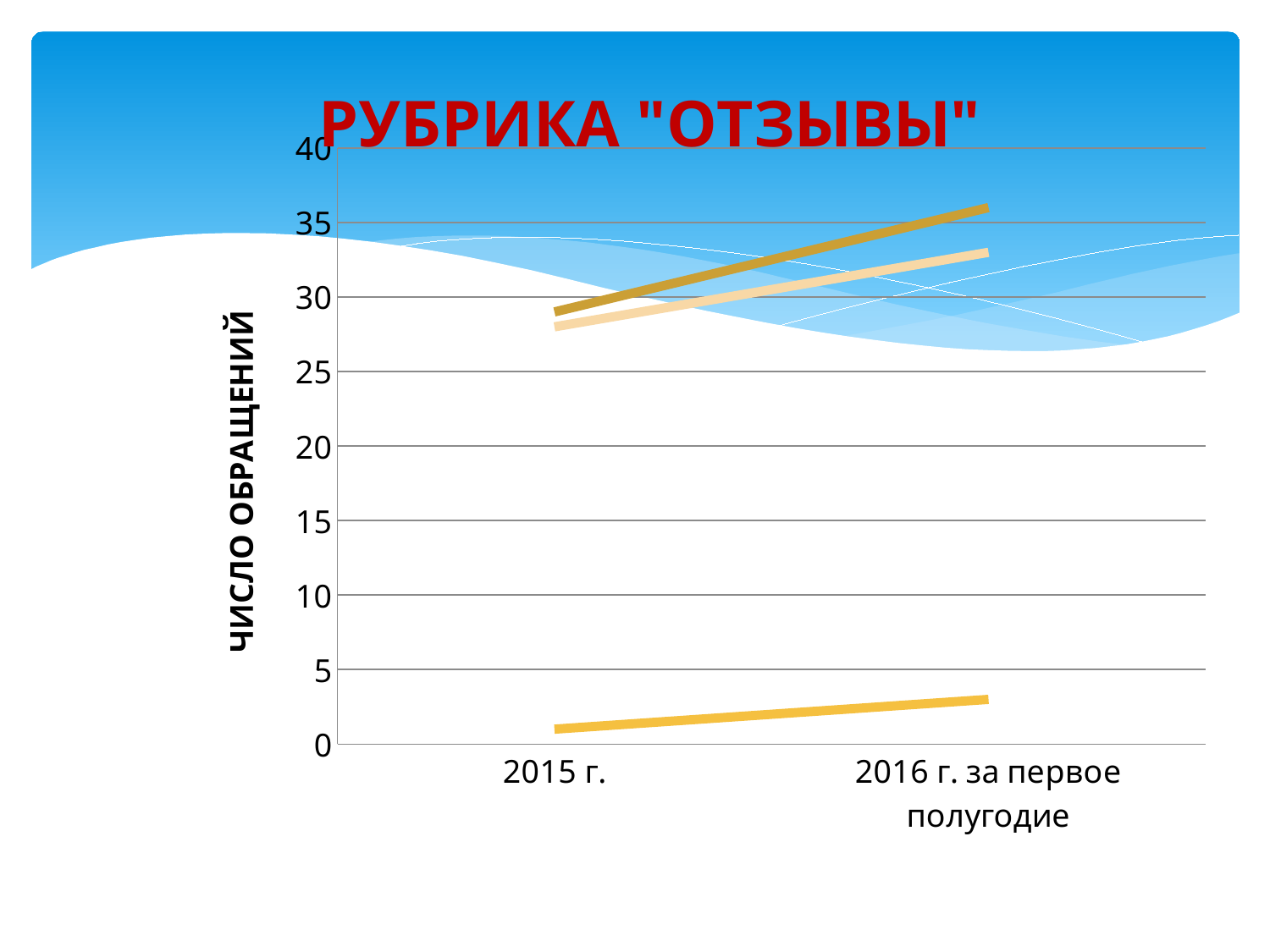
Is the value of the middle (light) line for 2016 г. за первое полугодие greater or less than 30? greater Do the values of the lowest line rise or fall from 2015 г. to 2016 г. за первое полугодие? rise Is the value of the middle (light) line for 2015 г. greater or less than 30? less How many lines are plotted on the chart? 3 What is the label of the vertical axis? ЧИСЛО ОБРАЩЕНИЙ How many categories are shown on the x axis? 2 Is the value of the lowest line for 2016 г. за первое полугодие greater or less than 5? less What is the title of the chart? РУБРИКА "ОТЗЫВЫ" Do the values of the topmost line rise or fall from 2015 г. to 2016 г. за первое полугодие? rise What kind of chart is shown on the slide? line chart